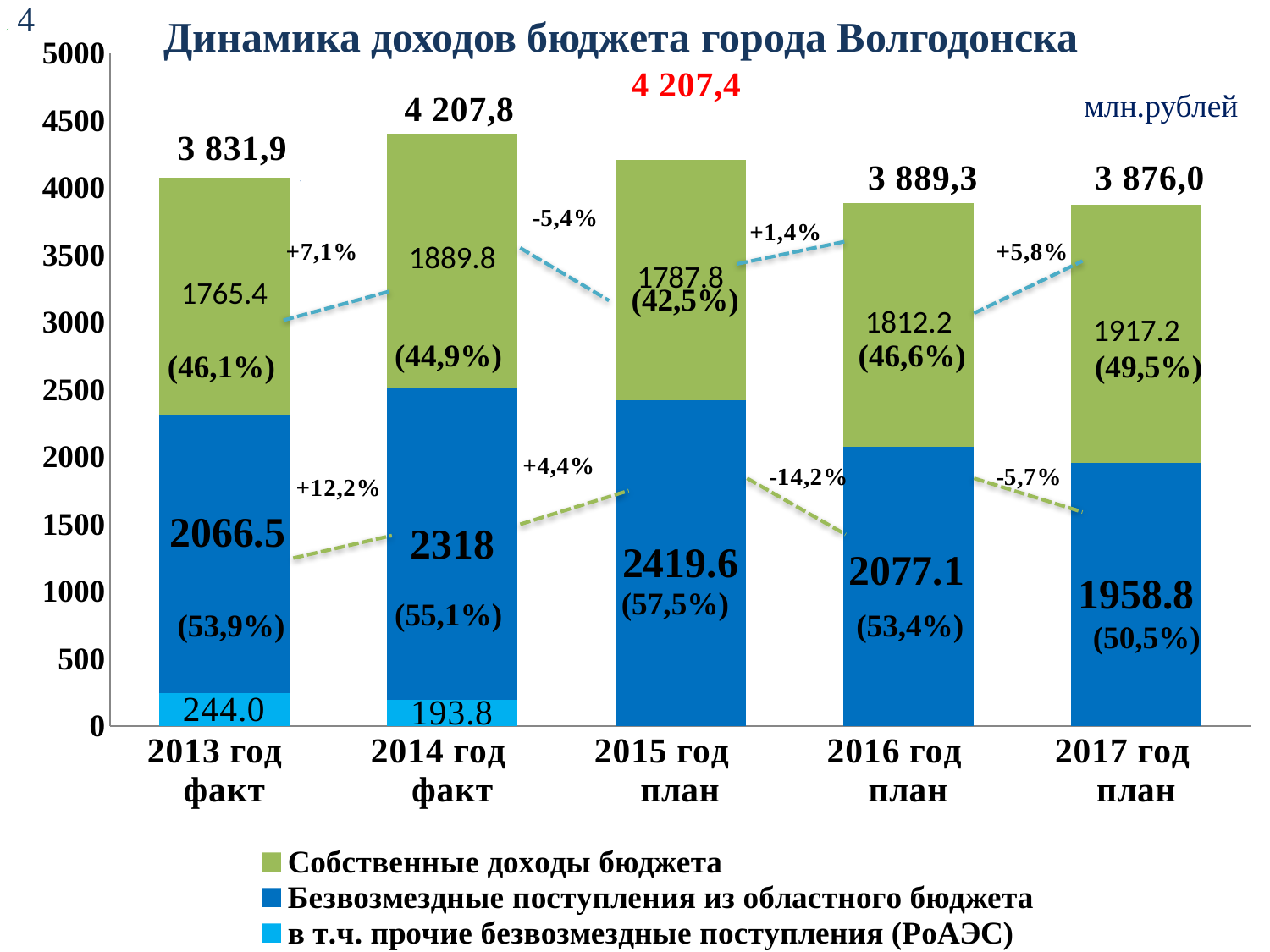
What is the difference between Собственные доходы бюджета in 2017 год план and in 2016 год план? 105.0 How many series does the legend list? 3 Which is larger: Безвозмездные поступления из областного бюджета in 2014 год факт or in 2016 год план? 2014 год факт In which year is the value of Собственные доходы бюджета the lowest? 2013 год факт How many years (categories) are shown on the x axis? 5 What is the difference between прочие безвозмездные поступления (РоАЭС) in 2013 год факт and in 2014 год факт? 50.2 What share of the budget do Собственные доходы бюджета make up in 2015 год план, as printed on the bar? 42,5% What is the total budget income shown above the bar for 2013 год факт? 3 831,9 In which year is the value of Безвозмездные поступления из областного бюджета the highest? 2015 год план What is the value of Безвозмездные поступления из областного бюджета for 2015 год план? 2419.6 What is the value of прочие безвозмездные поступления (РоАЭС) for 2013 год факт? 244.0 What is the value of Собственные доходы бюджета for 2017 год план? 1917.2